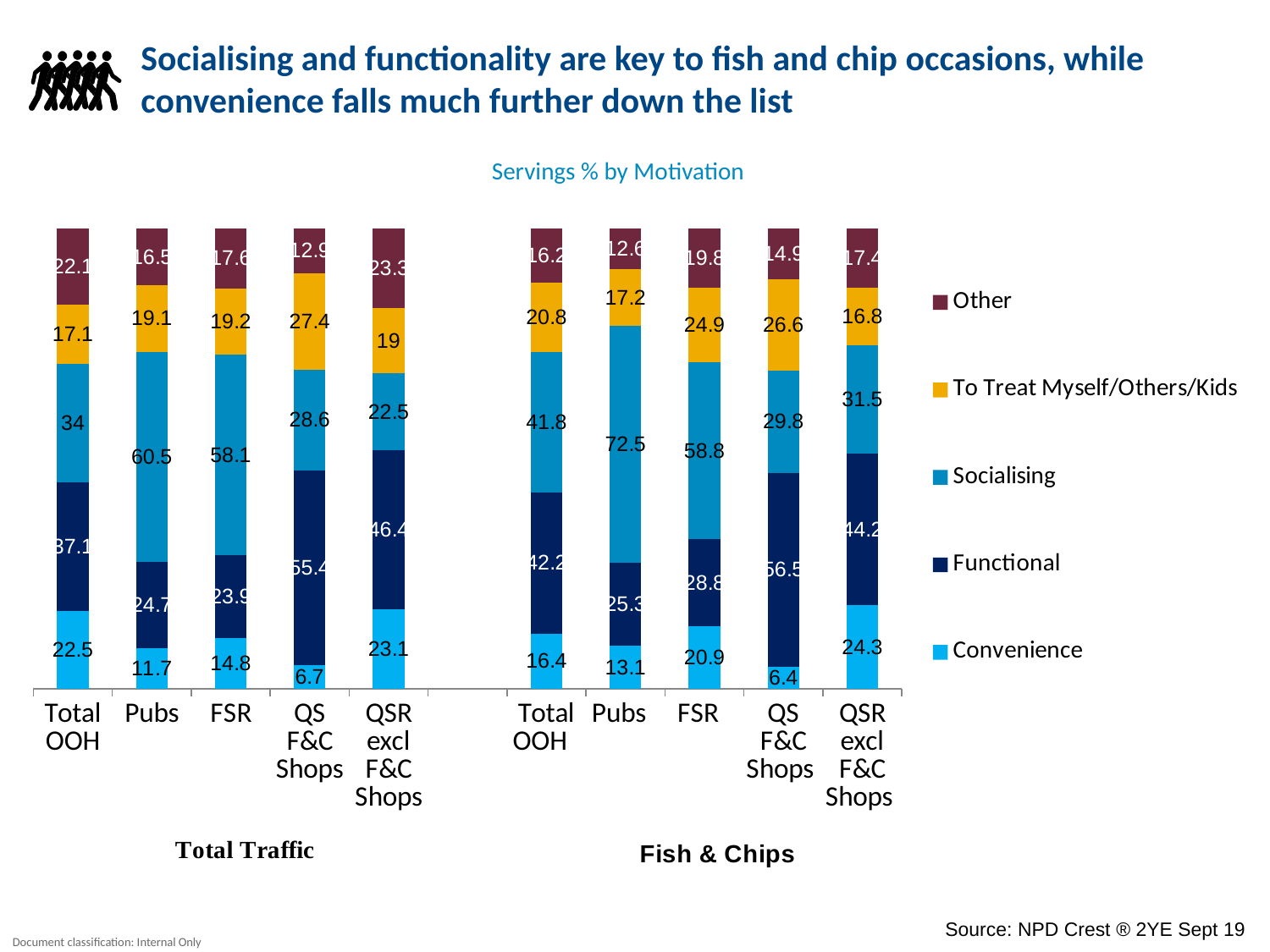
What kind of chart is shown on the slide? Stacked bar chart How many stacked bars are plotted in the chart in total? 10 In the Total Traffic group, what is the To Treat Myself/Others/Kids value for QSR excl F&C Shops? 19 What is the difference between the Socialising value for Pubs in the Fish & Chips group and in the Total Traffic group? 12 Is the Convenience value for Total OOH larger in the Total Traffic group or the Fish & Chips group? Total Traffic In the Total Traffic group, what is the Convenience value for QS F&C Shops? 6.7 In the Fish & Chips group, what is the To Treat Myself/Others/Kids value for FSR? 24.9 How many series does the legend list? 5 In the Fish & Chips group, which channel has the lowest Convenience value? QS F&C Shops What is the title of the chart? Servings % by Motivation In the Fish & Chips group, what is the Socialising value for Pubs? 72.5 In the Fish & Chips group, which channel has the highest Socialising value? Pubs